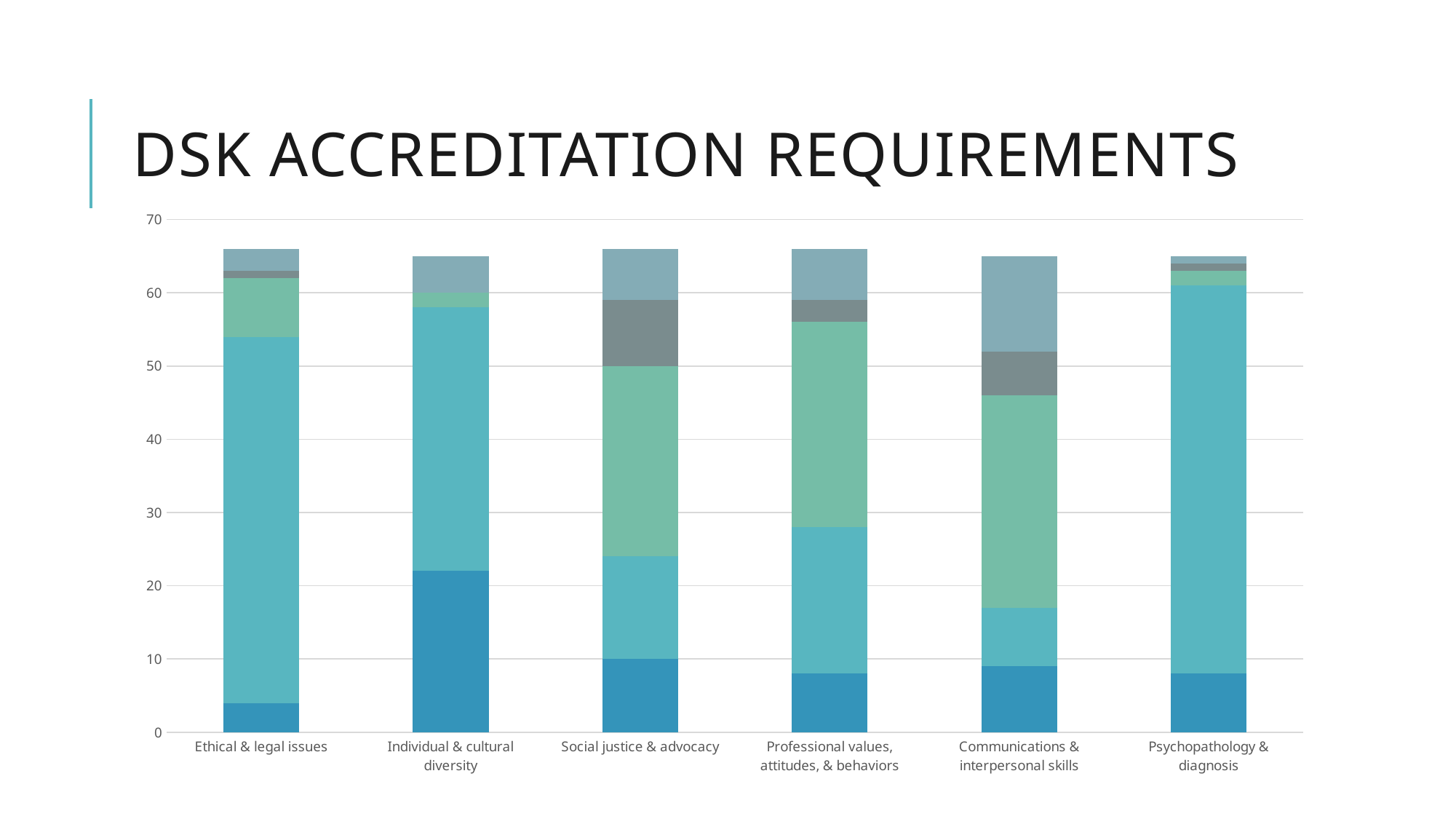
Which category has the larger bottom (darkest blue) segment: Ethical & legal issues or Individual & cultural diversity? Individual & cultural diversity Which category has the larger green (third from bottom) segment: Communications & interpersonal skills or Psychopathology & diagnosis? Communications & interpersonal skills Does the chart display a legend identifying the stacked segments? No What kind of chart is shown on the slide? Stacked bar chart Is the bottom (darkest blue) segment of the bar for Ethical & legal issues greater or less than 10? less Is the total height of the stacked bar for Ethical & legal issues greater or less than 60? greater Which category has the largest bottom (darkest blue) segment? Individual & cultural diversity How many categories are shown on the x axis of the chart? 6 Which category has the largest second-from-bottom (teal) segment? Psychopathology & diagnosis What is the title of the slide containing the chart? DSK ACCREDITATION REQUIREMENTS Is the bottom (darkest blue) segment of the bar for Individual & cultural diversity greater or less than 10? greater